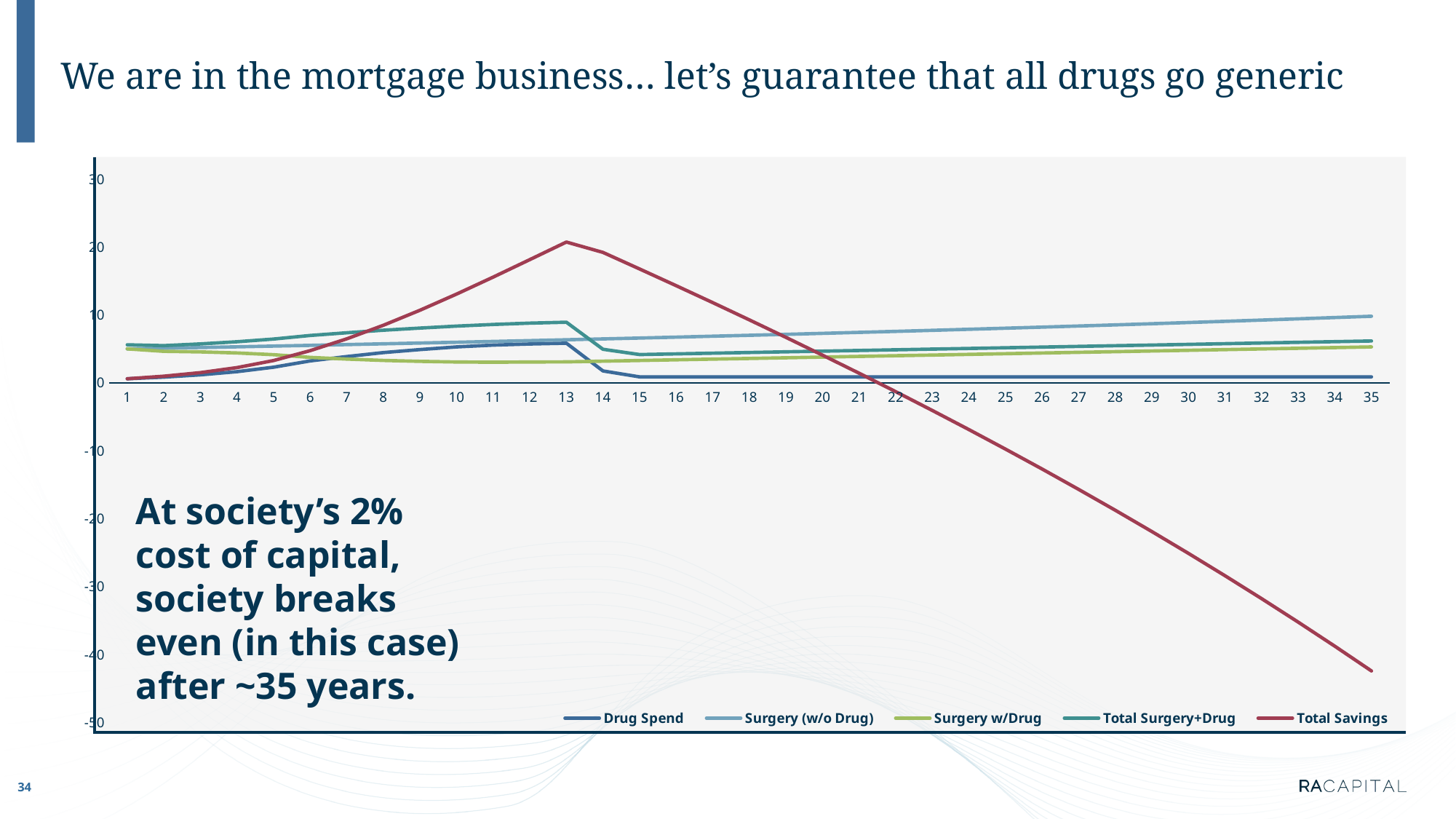
What colour is the Total Savings line in the chart? red Does the Drug Spend line rise or fall from x = 1 to x = 13? rise At which x-axis value does the Total Savings line reach its highest point? 13 Is the value of Total Savings at x = 30 greater or less than -20? less Is the value of Drug Spend at x = 20 greater or less than 10? less Does the Total Savings line rise or fall from x = 13 to x = 35? fall How many points are labelled along the x axis of the chart? 35 What kind of chart is shown on the slide? line chart Is the value of Total Savings at x = 1 greater or less than 10? less Which series has the lowest value at x = 35? Total Savings How many series does the chart's legend list? 5 At x = 35, which is higher: Surgery (w/o Drug) or Surgery w/Drug? Surgery (w/o Drug)